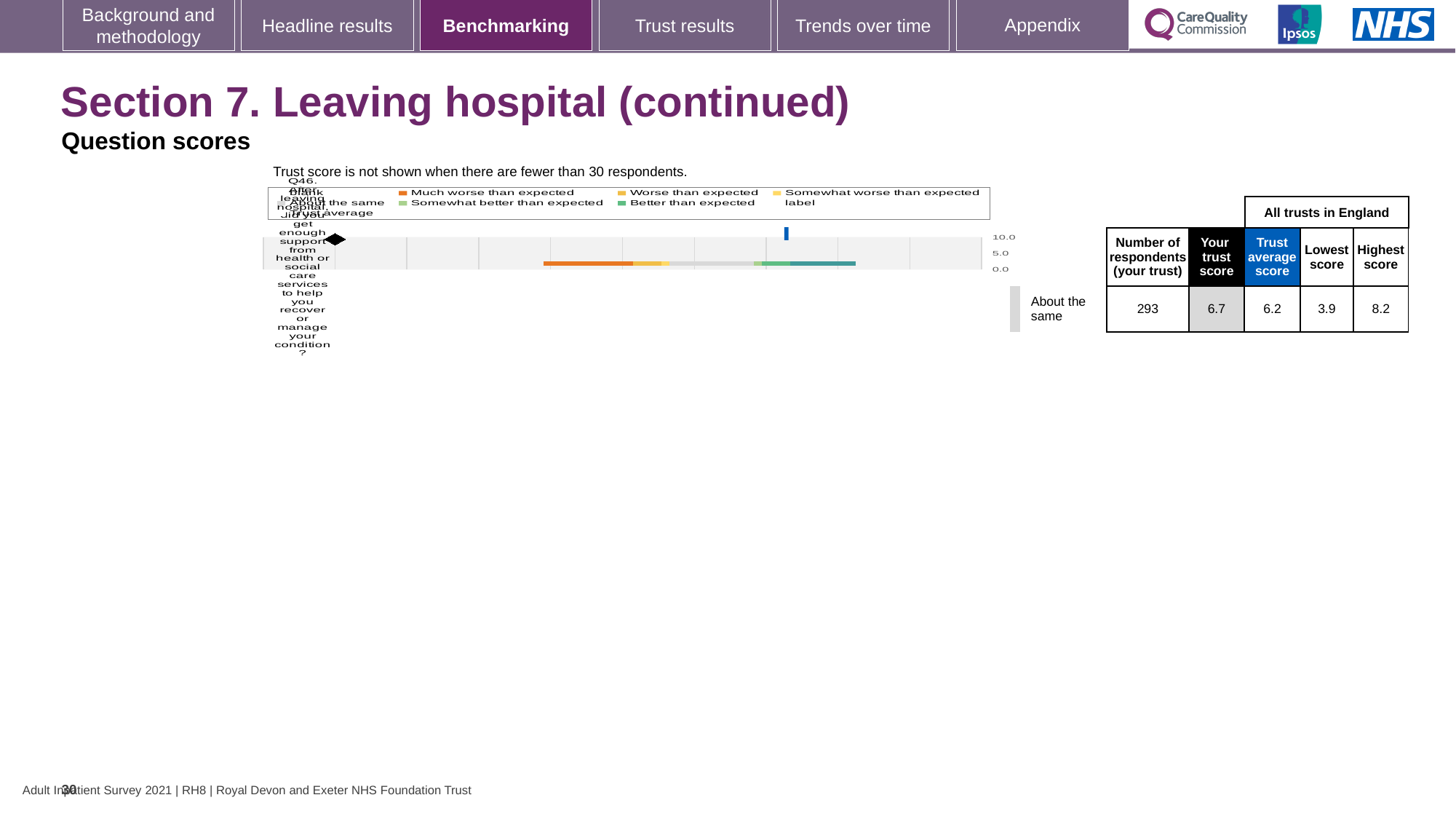
What is the highest value shown on the chart's axis? 10.0 Which is larger for Q46: the trust score or the trust average score? the trust score What is the trust score for Q46 (Your trust score)? 6.7 What kind of chart is shown on the slide for Q46? bar chart What is the highest score across all trusts in England for Q46? 8.2 What is the difference between the trust score and the trust average score for Q46? 0.5 What is the lowest score across all trusts in England for Q46? 3.9 How many respondents from the trust answered Q46? 293 What is the trust average score for Q46? 6.2 Is the trust score for Q46 greater or less than 5.0? greater How many questions are plotted on the chart? 1 What is the difference between the highest and lowest scores for Q46? 4.3